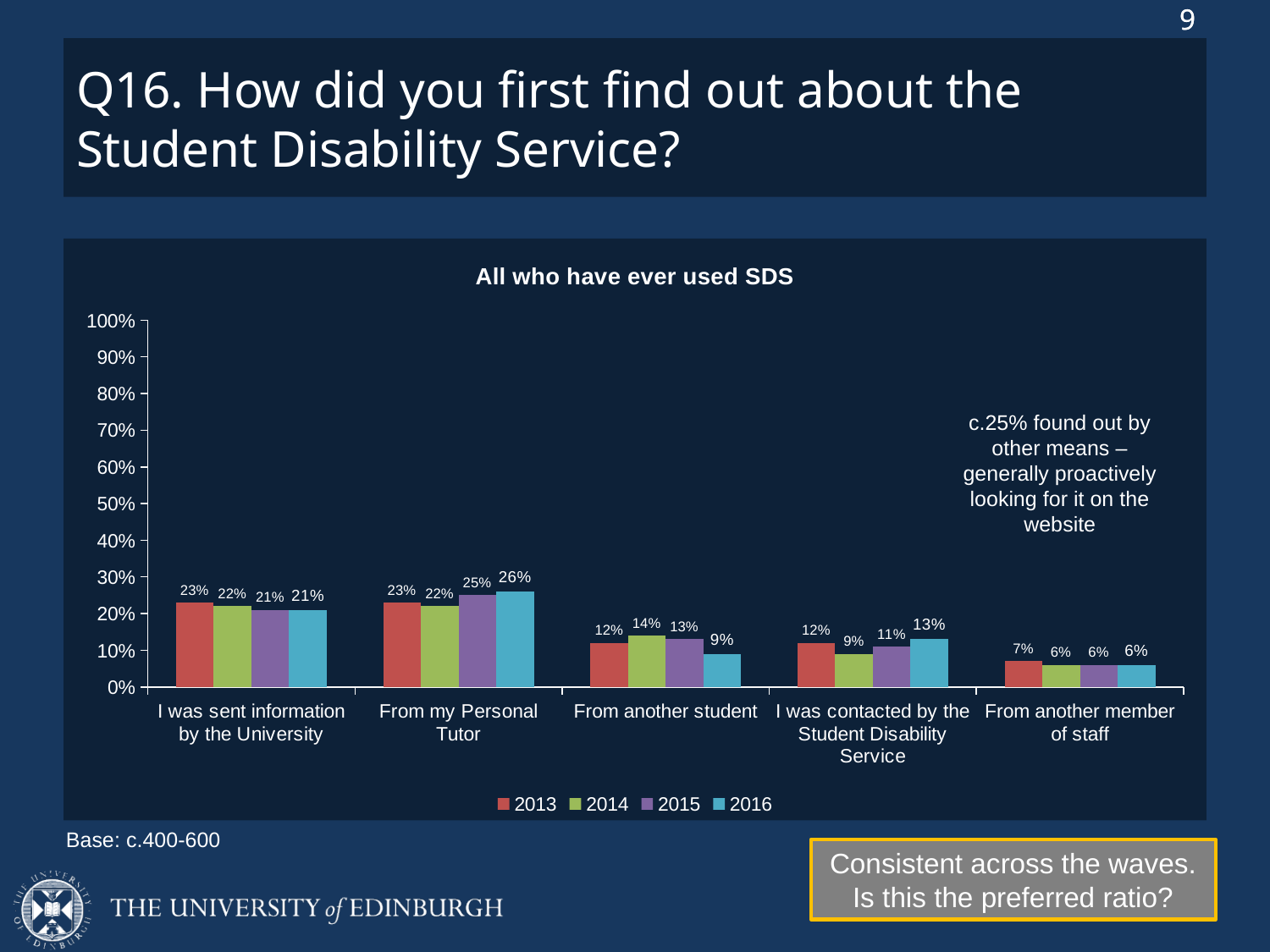
Which category has the lowest 2016 value? From another member of staff What is the 2015 value for 'I was contacted by the Student Disability Service'? 11% What kind of chart is shown on the slide? Bar chart Which category has the highest 2016 value? From my Personal Tutor How many categories are shown on the x axis? 5 How many series does the legend list? 4 What is the 2016 value for 'From my Personal Tutor'? 26% What is the 2014 value for 'From another student'? 14% What is the difference between the 2016 values for 'From my Personal Tutor' and 'From another student'? 17% What is the 2013 value for 'I was sent information by the University'? 23% Which is larger: the 2013 value for 'From another member of staff' or the 2013 value for 'From another student'? From another student What is the title of the chart? All who have ever used SDS